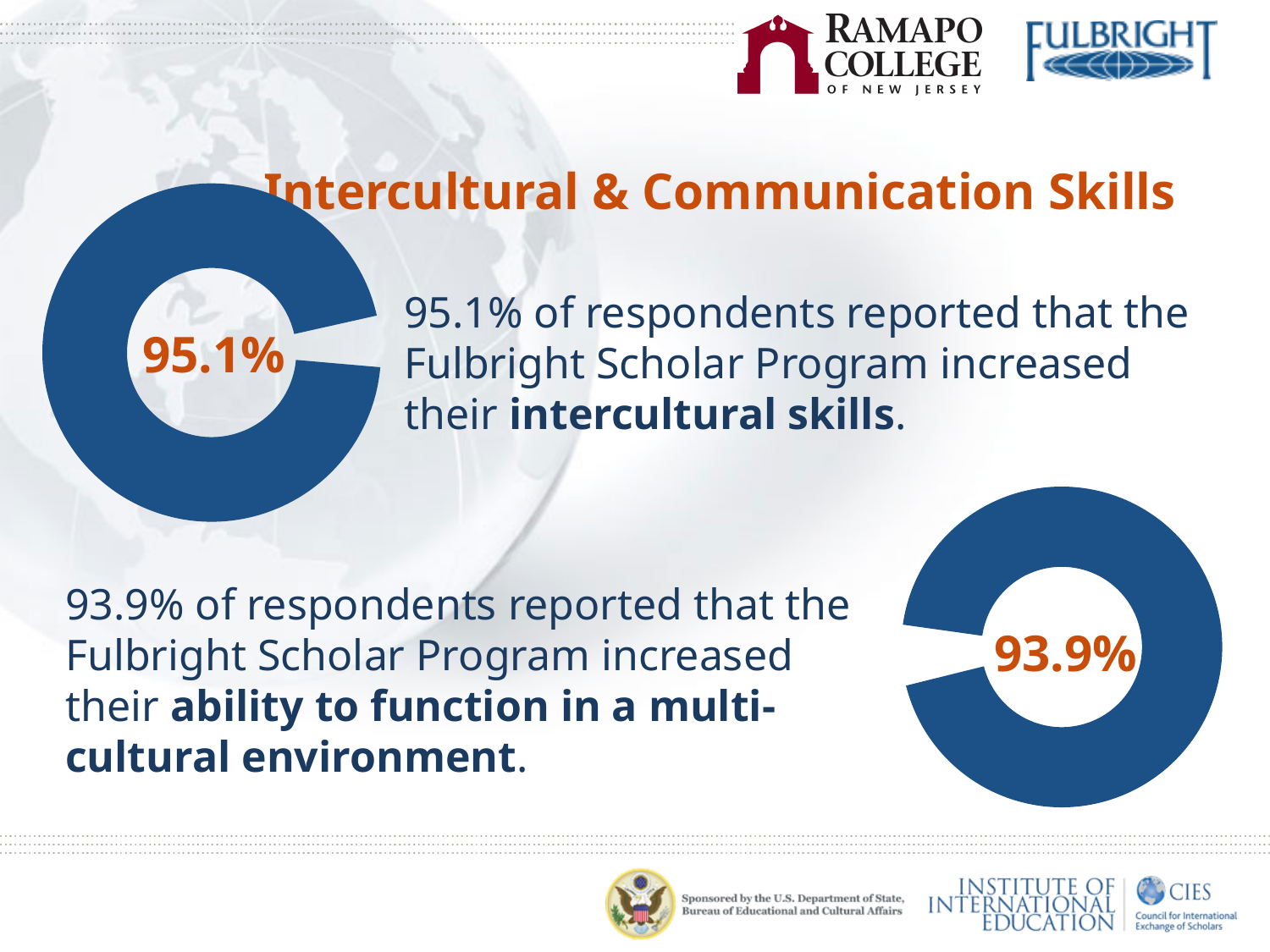
What colour are the filled portions of the donut charts? Blue What is the title of the slide containing the two donut charts? Intercultural & Communication Skills What value is shown in the centre of the right donut chart? 93.9% How many donut charts are on the slide? 2 What percentage of respondents reported that the Fulbright Scholar Program increased their ability to function in a multi-cultural environment? 93.9% What kind of chart is used to display the percentages on this slide? Donut chart What percentage of respondents reported that the Fulbright Scholar Program increased their intercultural skills? 95.1% Which is larger: the value in the left donut chart or the value in the right donut chart? The left donut chart (95.1%) What value is shown in the centre of the left donut chart? 95.1% What is the difference between the value in the left donut chart (95.1%) and the value in the right donut chart (93.9%)? 1.2 percentage points What share of the left donut chart does the filled blue portion represent? 95.1%